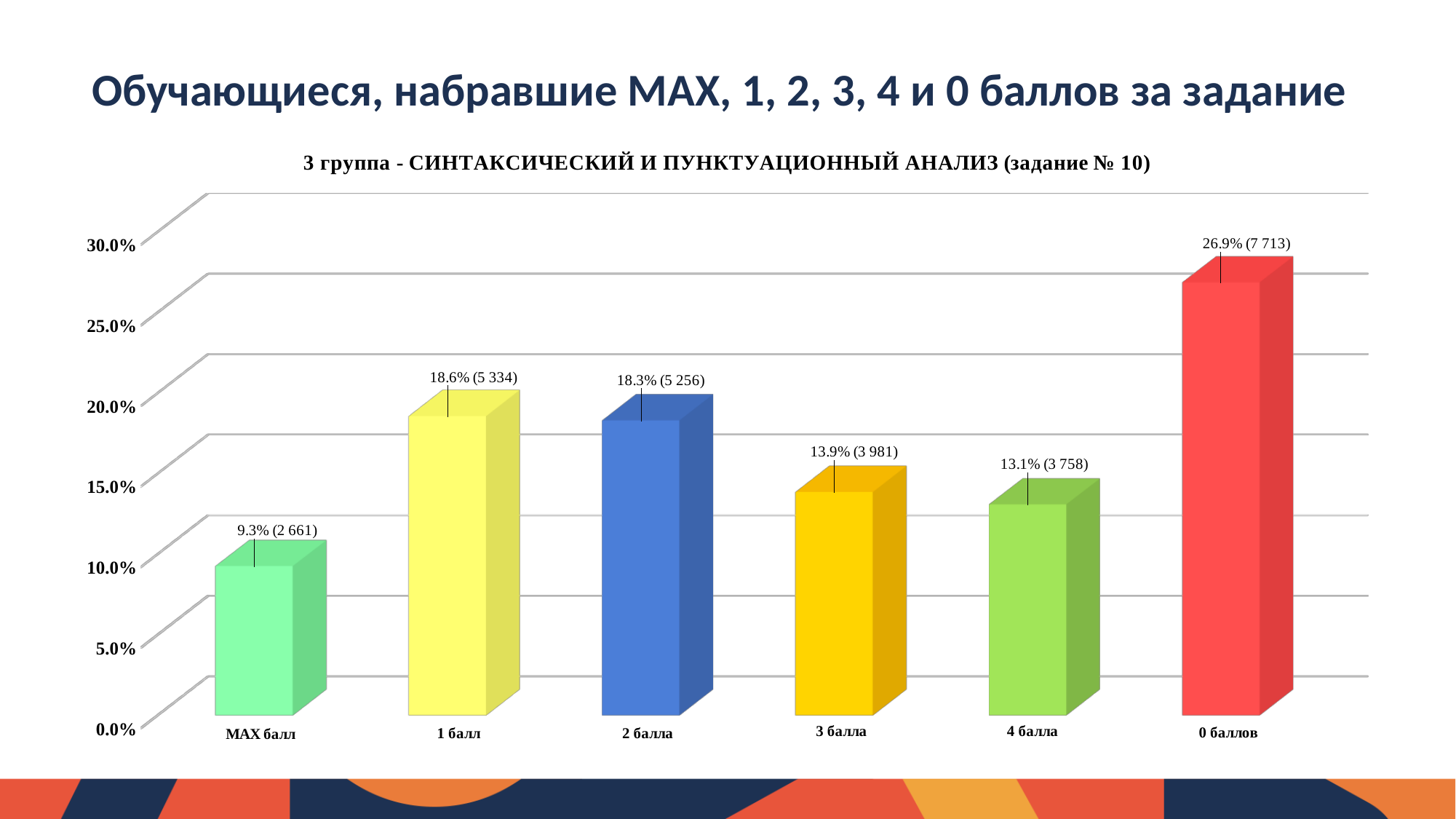
What percentage of students scored 0 баллов? 26.9% Which is larger, the percentage for 1 балл or for 4 балла? 1 балл Which category has the highest percentage? 0 баллов What is the data label shown for the 3 балла bar? 13.9% (3 981) How many students scored MAX балл, according to the data label? 2 661 What colour is the bar for 0 баллов? red What kind of chart is shown on the slide? bar chart What is the difference in percentage points between 0 баллов and MAX балл? 17.6% What is the difference in percentage points between 3 балла and 4 балла? 0.8% How many categories are shown on the x axis? 6 Which category has the lowest percentage? MAX балл Is the value for 2 балла greater or less than 15.0%? greater